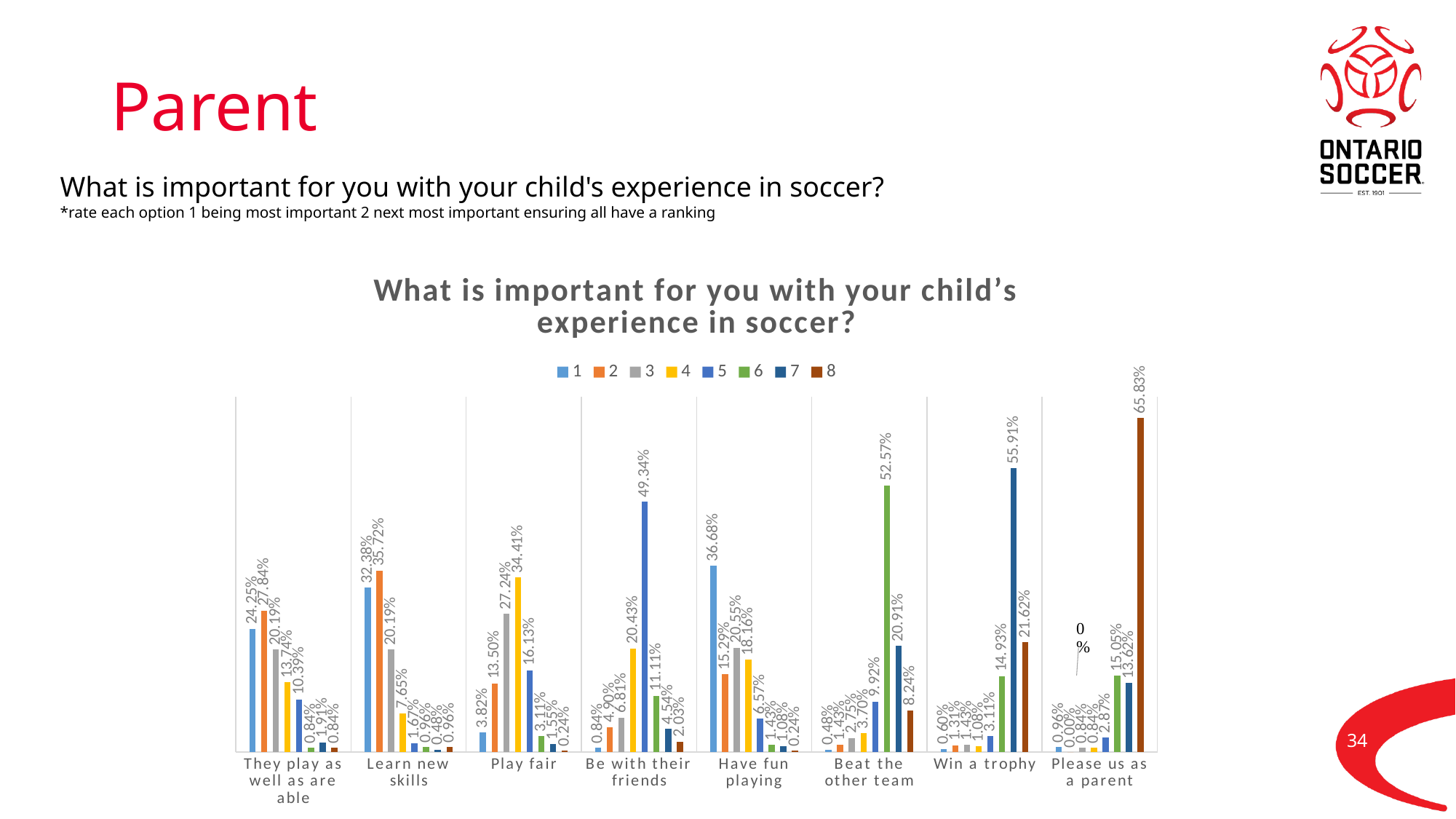
Which series has the highest value in the 'Play fair' category? 4 What is the value for series 1 in the 'Have fun playing' category? 36.68% Which category has the highest value for series 6? Beat the other team How many series does the legend list? 8 What is the value for series 8 in the 'Please us as a parent' category? 65.83% What is the value for series 2 in the 'Please us as a parent' category? 0.00% What is the difference between series 2 and series 1 in the 'Learn new skills' category? 3.34% What is the value for series 5 in the 'Be with their friends' category? 49.34% Which category has the highest value for series 7? Win a trophy What kind of chart is shown on the slide? bar chart How many categories are shown on the x axis? 8 Which is larger: series 1 in 'They play as well as are able' or series 1 in 'Learn new skills'? Learn new skills